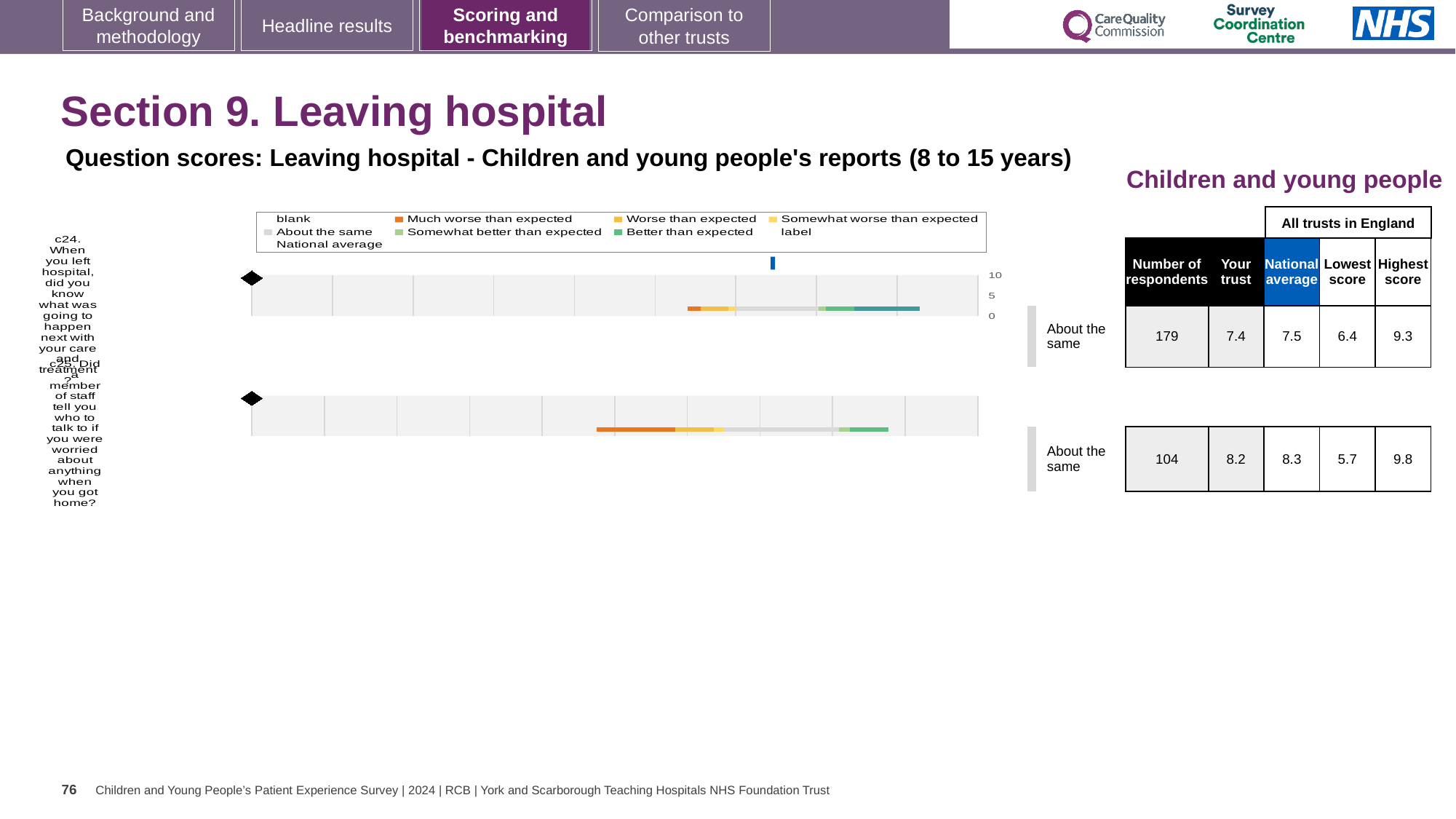
Which colour in the legend represents 'Much worse than expected'? orange What is the lowest score across all trusts in England for question c24? 6.4 What is the 'Your trust' score for question c24 (When you left hospital, did you know what was going to happen next with your care and treatment?)? 7.4 What is the difference in the number of respondents between question c24 and question c25? 75 Which question had more respondents, c24 or c25? c24 What is the highest score across all trusts in England for question c25? 9.8 What benchmark category is shown for question c25? About the same How many respondents answered question c24? 179 What kind of chart is used to show the question scores on this slide? bar chart How many survey questions are plotted in the chart? 2 What is the national average score for question c25 (Did a member of staff tell you who to talk to if you were worried about anything when you got home?)? 8.3 For question c24, is the 'Your trust' score higher or lower than the national average? lower